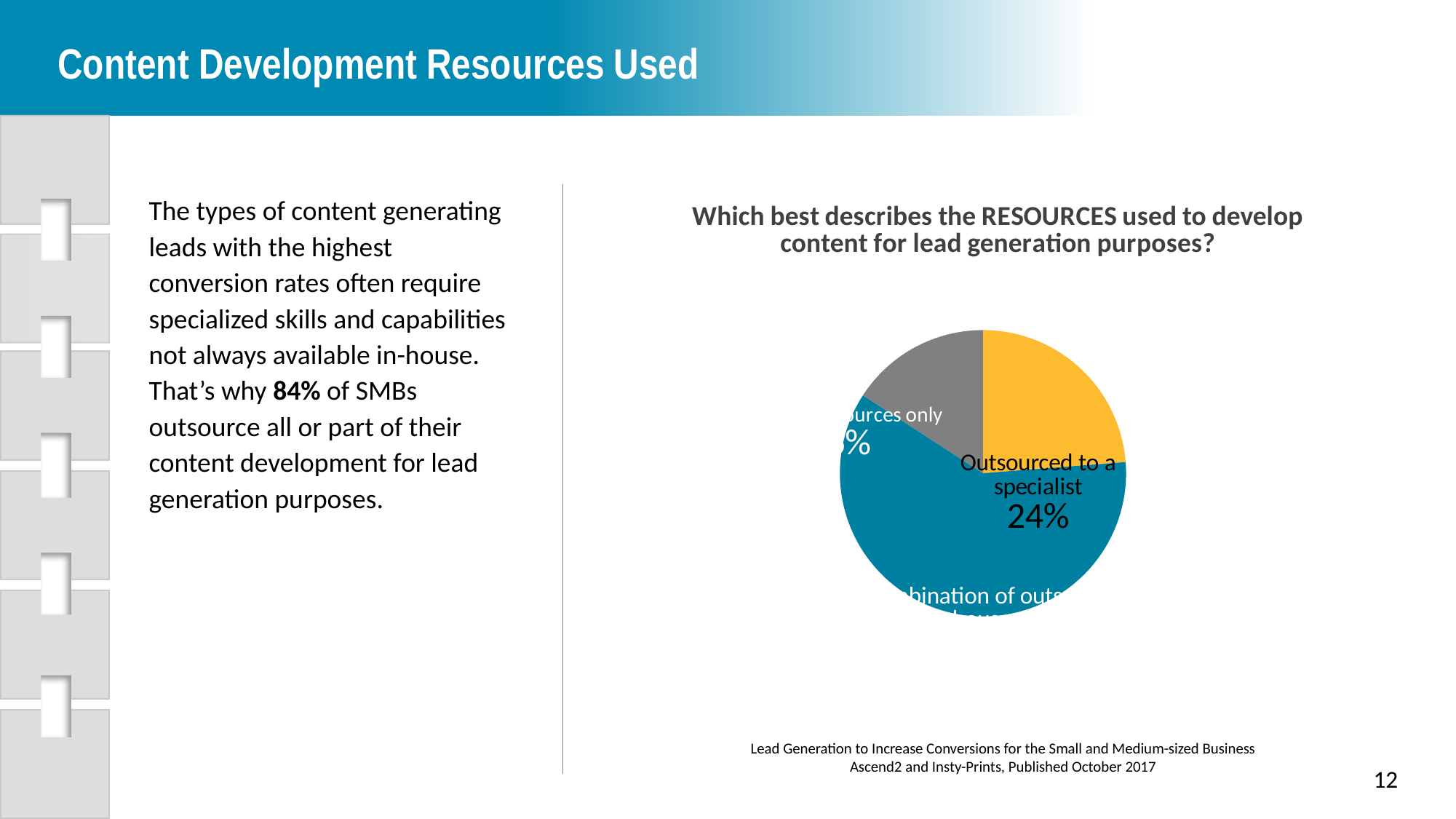
Is the share for 'Outsourced to a specialist' greater or less than 50%? less What kind of chart is shown on the slide? pie chart Which is larger, the yellow slice or the teal slice? the teal slice Which colour slice is the smallest in the pie chart? grey What percentage of respondents said content development is outsourced to a specialist? 24% What colour is the 'Outsourced to a specialist' slice? yellow How many slices does the pie chart have? 3 Which colour slice is the largest in the pie chart? teal What is the title of the pie chart? Which best describes the RESOURCES used to develop content for lead generation purposes?